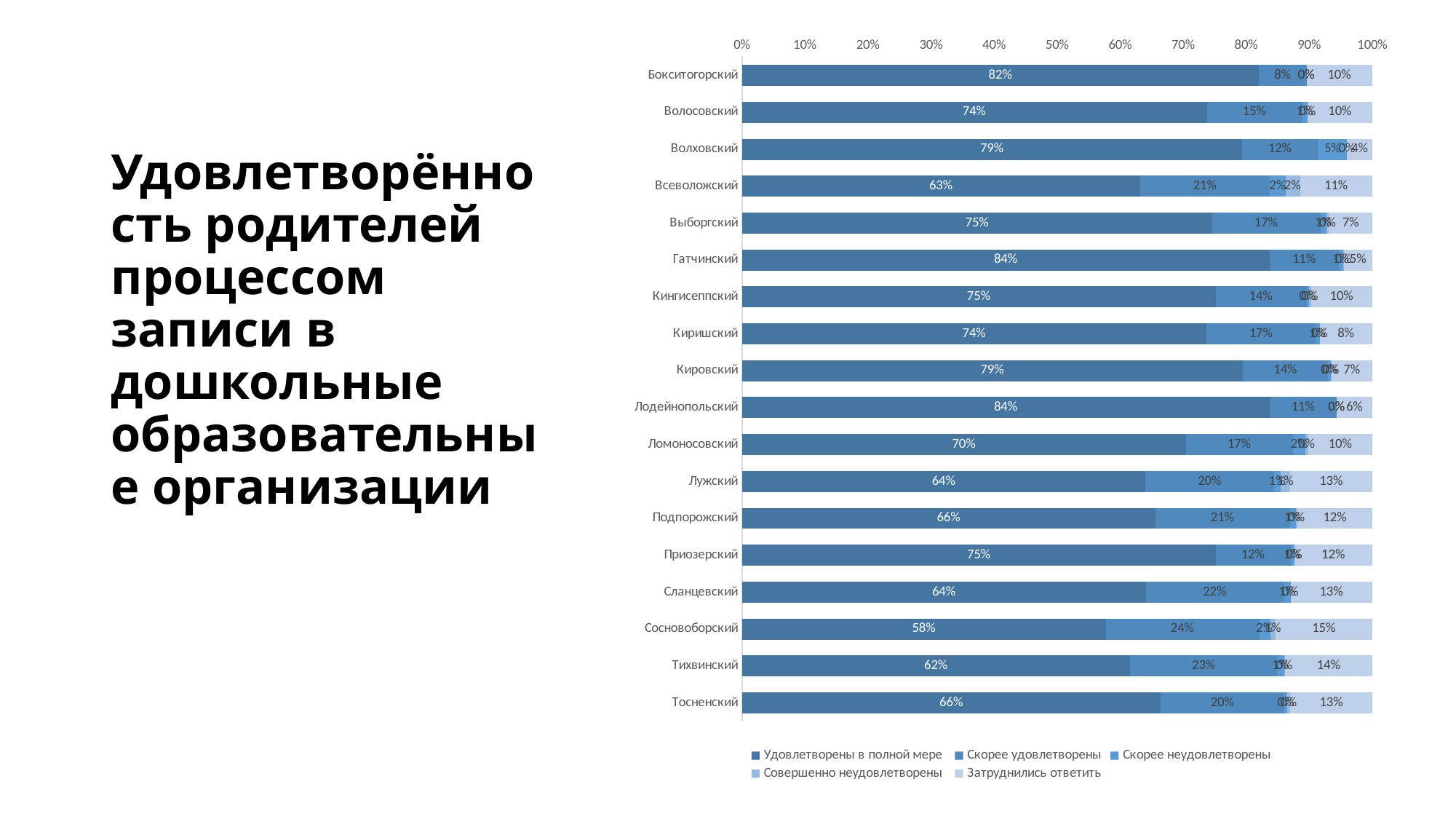
Which district has a larger 'Удовлетворены в полной мере' share, Волховский or Ломоносовский? Волховский What share of parents in Бокситогорский are 'Удовлетворены в полной мере'? 82% Which district has the highest 'Скорее удовлетворены' share? Сосновоборский What kind of chart is shown on the slide? Stacked bar chart What is the first legend entry of the chart? Удовлетворены в полной мере Which district has the highest 'Затруднились ответить' share? Сосновоборский What is the 'Затруднились ответить' value for Лужский? 13% Which district has the lowest 'Удовлетворены в полной мере' share? Сосновоборский How many districts are shown on the chart? 18 What is the difference in the 'Удовлетворены в полной мере' share between Бокситогорский and Сосновоборский? 24 percentage points What is the 'Скорее удовлетворены' value for Сосновоборский? 24% How many series does the legend list? 5